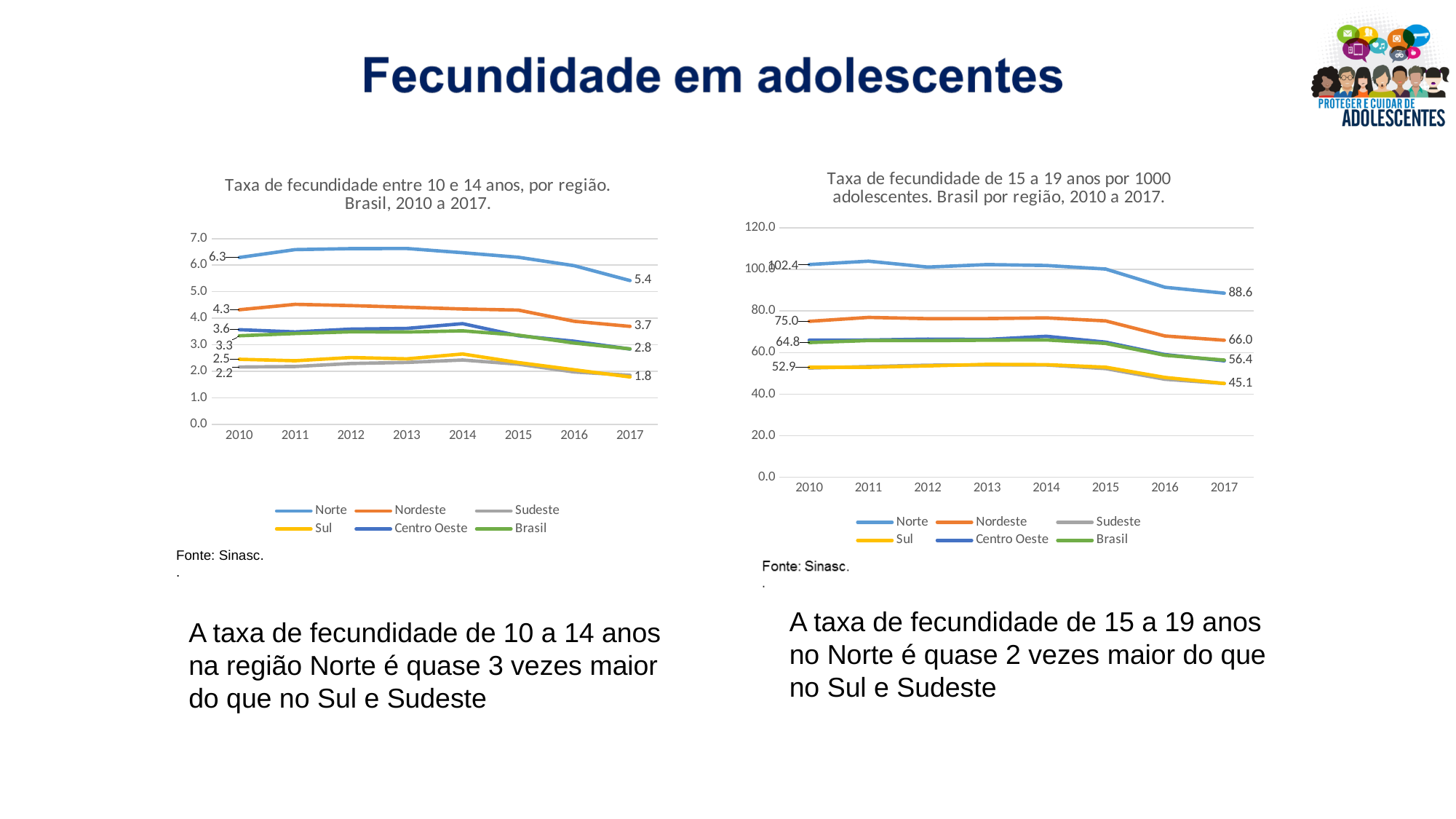
In the right chart (Taxa de fecundidade de 15 a 19 anos), what is the difference between the Norte values in 2010 and 2017? 13.8 In the left chart (Taxa de fecundidade entre 10 e 14 anos), which region has the lowest value in 2010? Sudeste In the left chart (Taxa de fecundidade entre 10 e 14 anos), what is the value for Norte in 2017? 5.4 What kind of chart is the right chart (Taxa de fecundidade de 15 a 19 anos)? line chart In the left chart (Taxa de fecundidade entre 10 e 14 anos), by how much did the Norte value fall from 2010 to 2017? 0.9 In the right chart (Taxa de fecundidade de 15 a 19 anos), what is the value for Norte in 2010? 102.4 How many series does the legend of the left chart list? 6 In the right chart (Taxa de fecundidade de 15 a 19 anos), is the Norte value in 2017 greater or less than 80.0? greater In the left chart (Taxa de fecundidade entre 10 e 14 anos), which region has the highest values across the whole period? Norte In the left chart (Taxa de fecundidade entre 10 e 14 anos), what is the value for Norte in 2010? 6.3 In the left chart (Taxa de fecundidade entre 10 e 14 anos), what is the value for Nordeste in 2017? 3.7 In the left chart (Taxa de fecundidade entre 10 e 14 anos), does the Norte line rise or fall between 2014 and 2017? fall